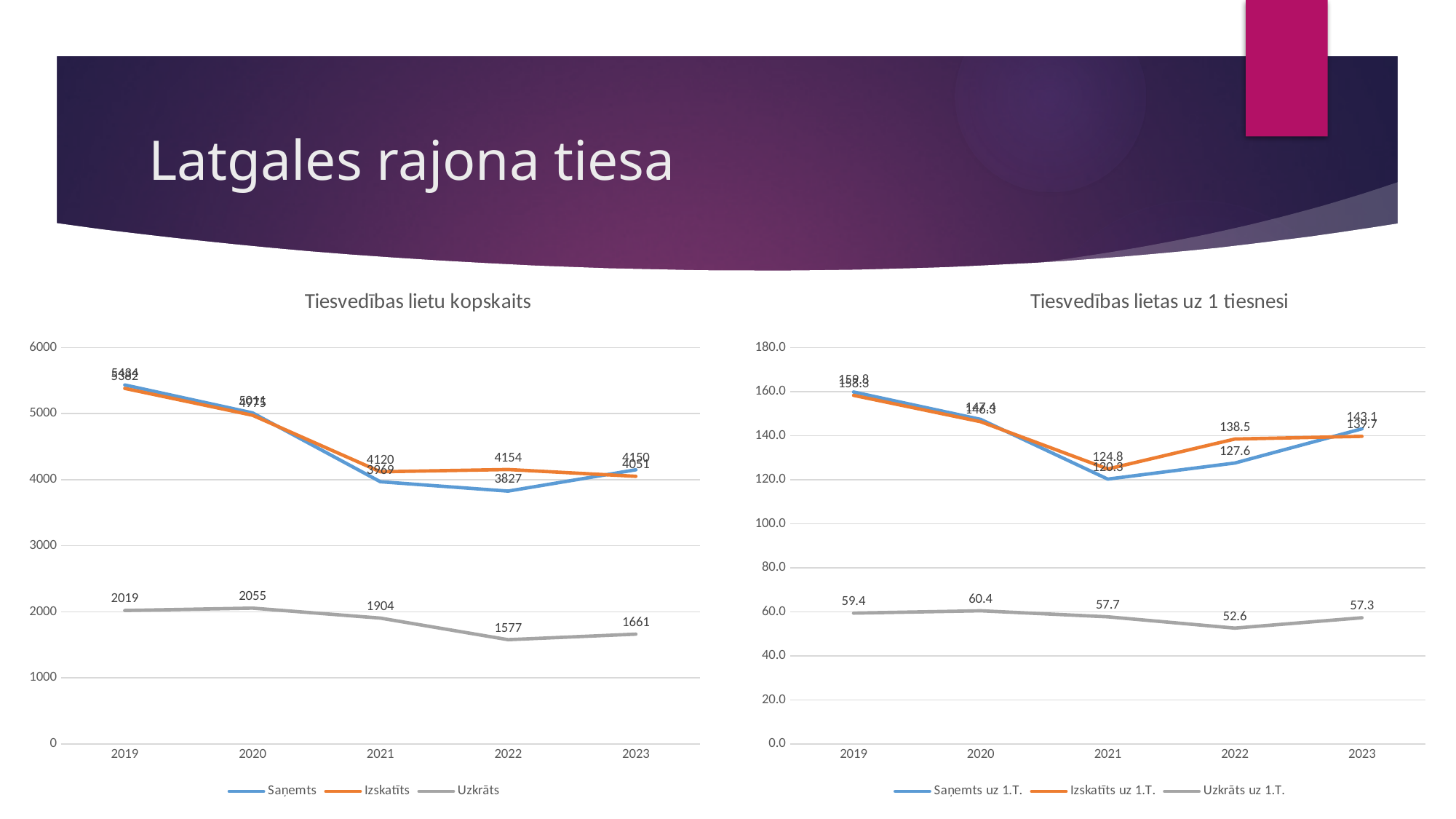
In the chart 'Tiesvedības lietu kopskaits', what is the value of Uzkrāts in 2022? 1577 In the chart 'Tiesvedības lietu kopskaits', how many series does the legend list? 3 In the chart 'Tiesvedības lietas uz 1 tiesnesi', in which year is Uzkrāts uz 1.T. lowest? 2022 In the chart 'Tiesvedības lietu kopskaits', which is larger in 2022: Saņemts or Izskatīts? Izskatīts In the chart 'Tiesvedības lietu kopskaits', what is the value of Izskatīts in 2021? 4120 In the chart 'Tiesvedības lietas uz 1 tiesnesi', what is the value of Uzkrāts uz 1.T. in 2022? 52.6 In the chart 'Tiesvedības lietu kopskaits', in which year is Uzkrāts highest? 2020 What kind of chart is 'Tiesvedības lietas uz 1 tiesnesi'? Line chart In the chart 'Tiesvedības lietas uz 1 tiesnesi', what is the difference between Izskatīts uz 1.T. and Saņemts uz 1.T. in 2021? 4.5 In the chart 'Tiesvedības lietas uz 1 tiesnesi', what is the value of Izskatīts uz 1.T. in 2022? 138.5 In the chart 'Tiesvedības lietu kopskaits', what is the value of Saņemts in 2022? 3827 In the chart 'Tiesvedības lietu kopskaits', what is the difference between Uzkrāts in 2020 and in 2022? 478